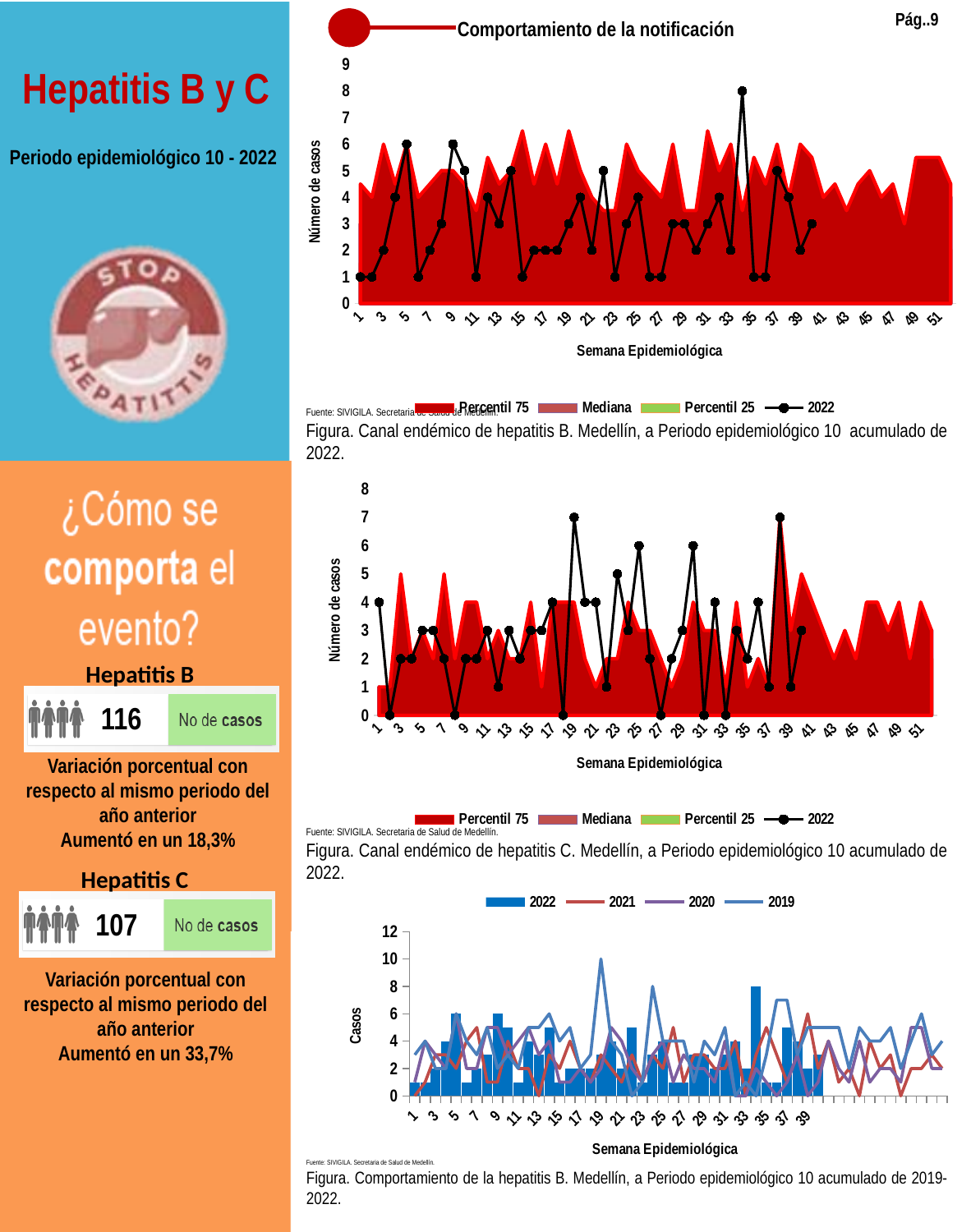
How many series does the legend of the top chart (Canal endémico de hepatitis B) list? 4 In the bottom chart (Comportamiento de la hepatitis B 2019-2022), is the highest value of the 2019 line greater or less than 8? greater In the bottom chart (Comportamiento de la hepatitis B 2019-2022), is the tallest 2022 bar greater or less than 6? greater In the middle chart (Canal endémico de hepatitis C), what is the highest value reached by the 2022 line? 7 In the middle chart (Canal endémico de hepatitis C), is the 2022 value at week 1 higher or lower than at week 2? higher In the bottom chart (Comportamiento de la hepatitis B 2019-2022), what kind of chart is used to show the 2022 series? bar chart In the middle chart (Canal endémico de hepatitis C), what is the 2022 value at week 1? 4 In the top chart (Canal endémico de hepatitis B), what is the 2022 value at week 1? 1 In the middle chart (Canal endémico de hepatitis C), what is the lowest value reached by the 2022 line? 0 In the top chart (Canal endémico de hepatitis B), what is the highest value reached by the 2022 line? 8 What is the x-axis title of the top chart (Canal endémico de hepatitis B)? Semana Epidemiológica How many series does the legend of the bottom chart (Comportamiento de la hepatitis B 2019-2022) list? 4